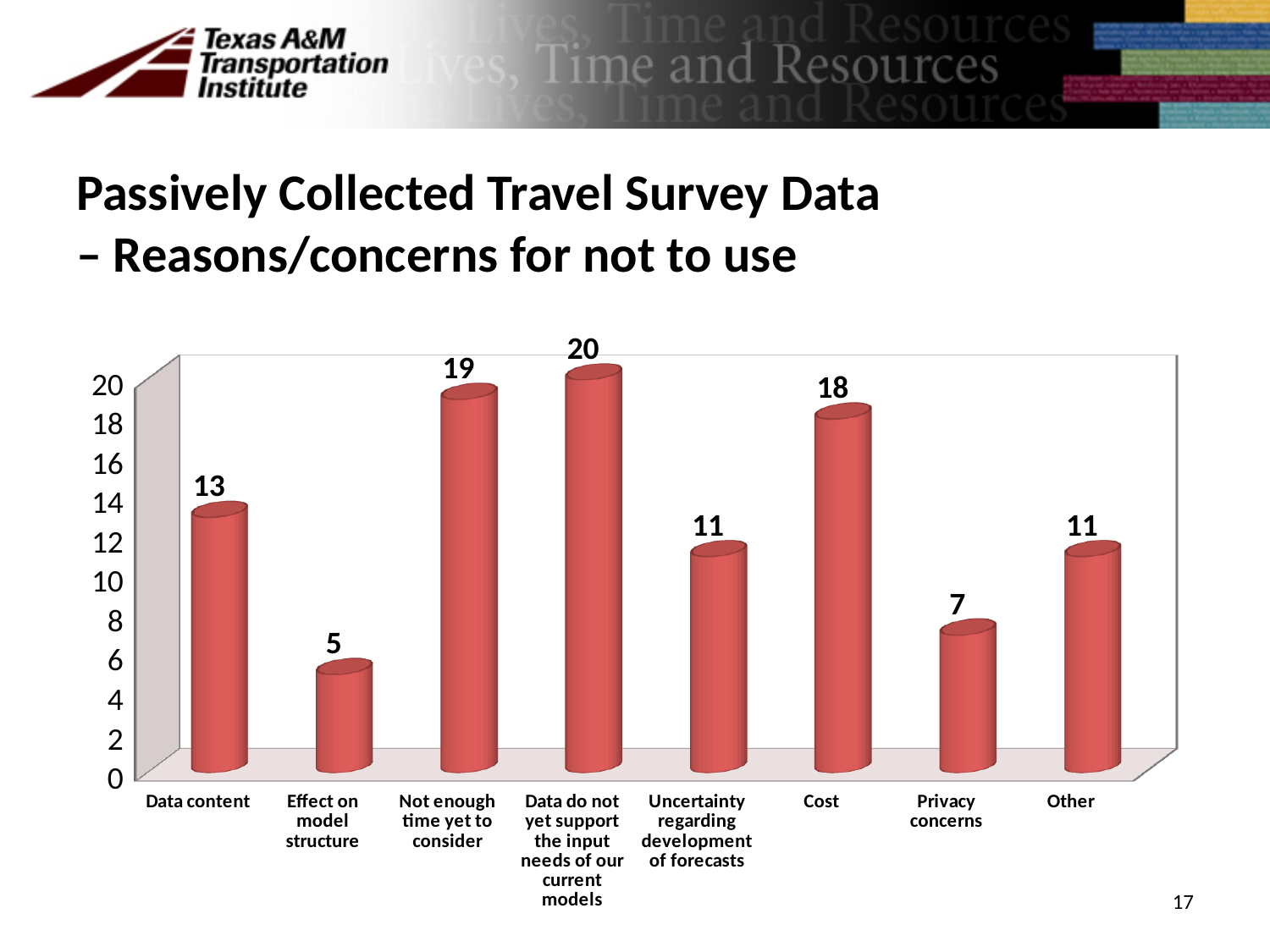
Which category has the lowest value? Effect on model structure What is the value for Cost? 18 How many categories are shown on the x axis? 8 What is the difference between the values for Not enough time yet to consider and Cost? 1 What is the value for Privacy concerns? 7 What is the difference between the values for Data content and Privacy concerns? 6 What is the value for Uncertainty regarding development of forecasts? 11 Is the value for Cost greater or less than 16? greater What is the value for Data content? 13 Which category has the highest value? Data do not yet support the input needs of our current models What kind of chart is shown on the slide? bar chart Which is larger, the value for Data content or the value for Other? Data content